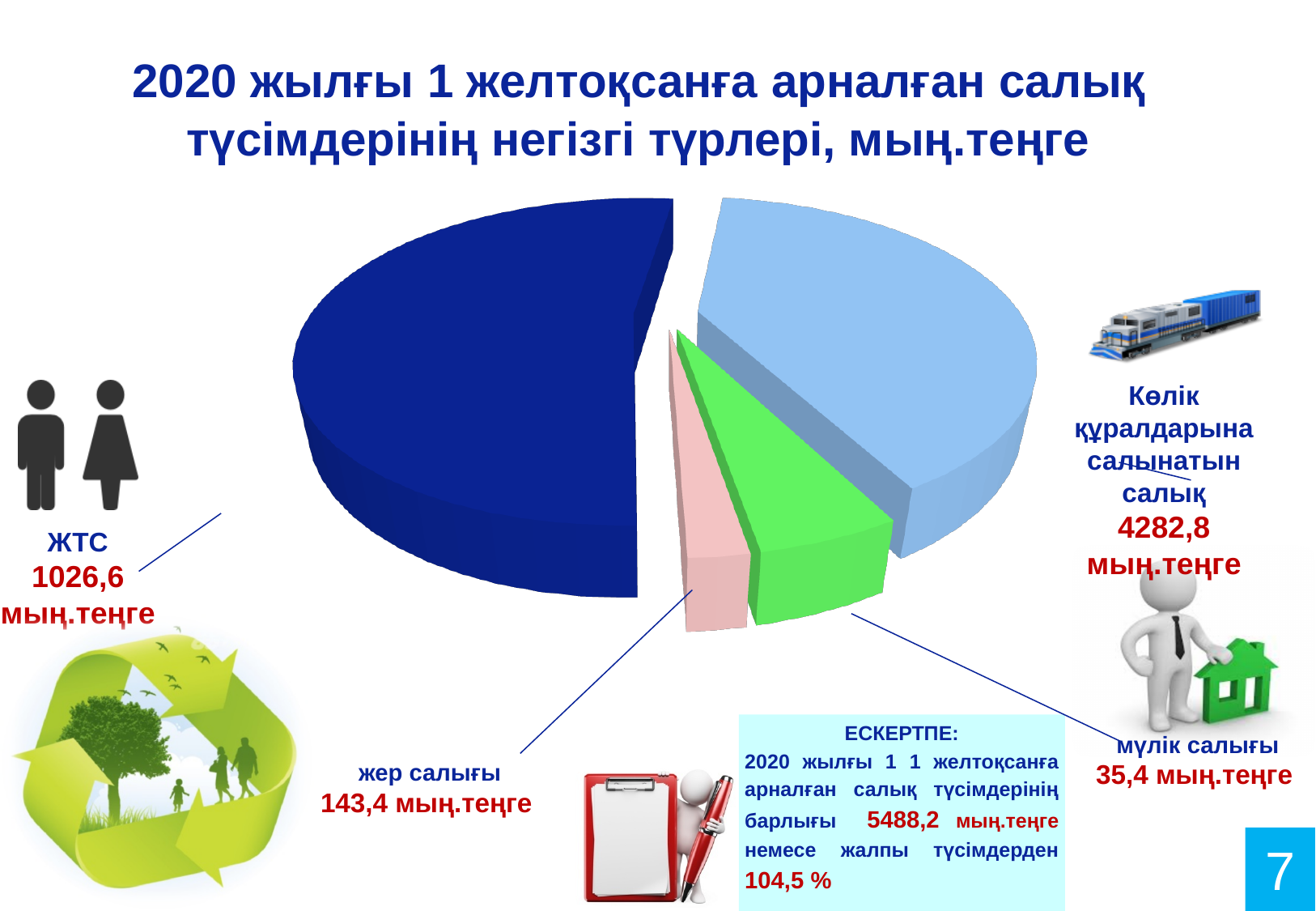
What is the value shown for ЖТС? 1026,6 мың.теңге What is the difference between the values for ЖТС and жер салығы? 883,2 мың.теңге What kind of chart is shown on the slide? pie chart Which tax type has the lowest value on the chart? мүлік салығы According to the note on the slide, what is the total of all tax receipts for 1 December 2020? 5488,2 мың.теңге What is the difference between the values for Көлік құралдарына салынатын салық and ЖТС? 3256,2 мың.теңге How many tax types are shown on the chart? 4 Which is larger, the value for жер салығы or the value for мүлік салығы? жер салығы Which tax type has the highest value on the chart? Көлік құралдарына салынатын салық What is the value shown for мүлік салығы? 35,4 мың.теңге What is the value shown for жер салығы? 143,4 мың.теңге What is the value shown for Көлік құралдарына салынатын салық? 4282,8 мың.теңге